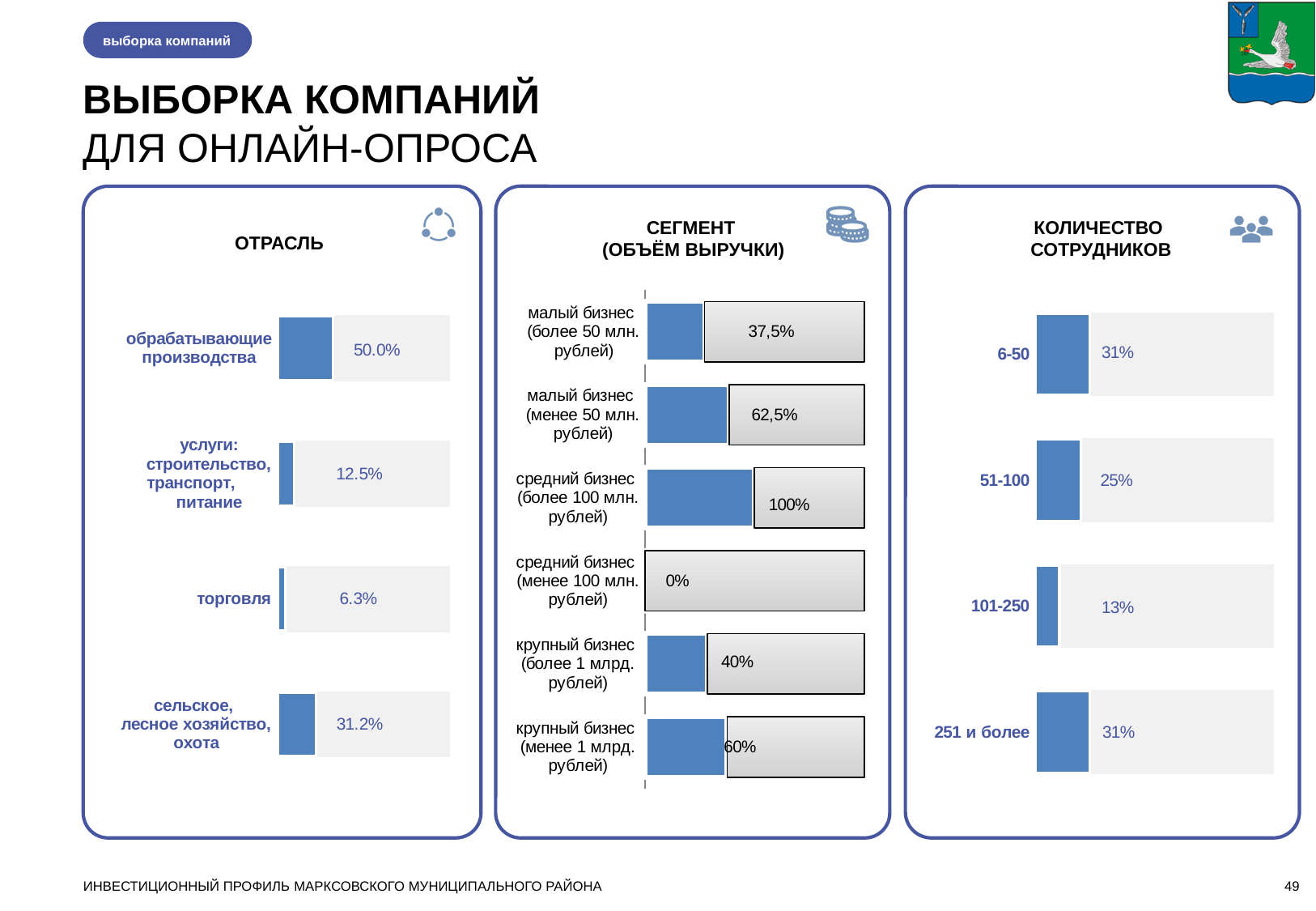
На диаграмме «КОЛИЧЕСТВО СОТРУДНИКОВ» какая категория имеет наименьшее значение? 101-250 На диаграмме «СЕГМЕНТ (ОБЪЁМ ВЫРУЧКИ)» какая категория имеет наибольшее значение? средний бизнес (более 100 млн. рублей) На диаграмме «ОТРАСЛЬ» сколько категорий показано? 4 На диаграмме «ОТРАСЛЬ» какая категория имеет наименьшее значение? торговля Какого типа диаграмма «КОЛИЧЕСТВО СОТРУДНИКОВ»? столбчатая (bar chart) На диаграмме «ОТРАСЛЬ» на сколько процентных пунктов значение «обрабатывающие производства» больше значения «сельское, лесное хозяйство, охота»? 18.8 На диаграмме «ОТРАСЛЬ» какое значение указано для категории «обрабатывающие производства»? 50.0% На диаграмме «КОЛИЧЕСТВО СОТРУДНИКОВ» какое значение указано для категории «51-100»? 25% На диаграмме «СЕГМЕНТ (ОБЪЁМ ВЫРУЧКИ)» что больше: значение для «крупный бизнес (более 1 млрд. рублей)» или для «крупный бизнес (менее 1 млрд. рублей)»? крупный бизнес (менее 1 млрд. рублей) На диаграмме «СЕГМЕНТ (ОБЪЁМ ВЫРУЧКИ)» какая категория имеет наименьшее значение? средний бизнес (менее 100 млн. рублей) На диаграмме «СЕГМЕНТ (ОБЪЁМ ВЫРУЧКИ)» сколько категорий показано? 6 На диаграмме «СЕГМЕНТ (ОБЪЁМ ВЫРУЧКИ)» какое значение указано для «малый бизнес (менее 50 млн. рублей)»? 62,5%